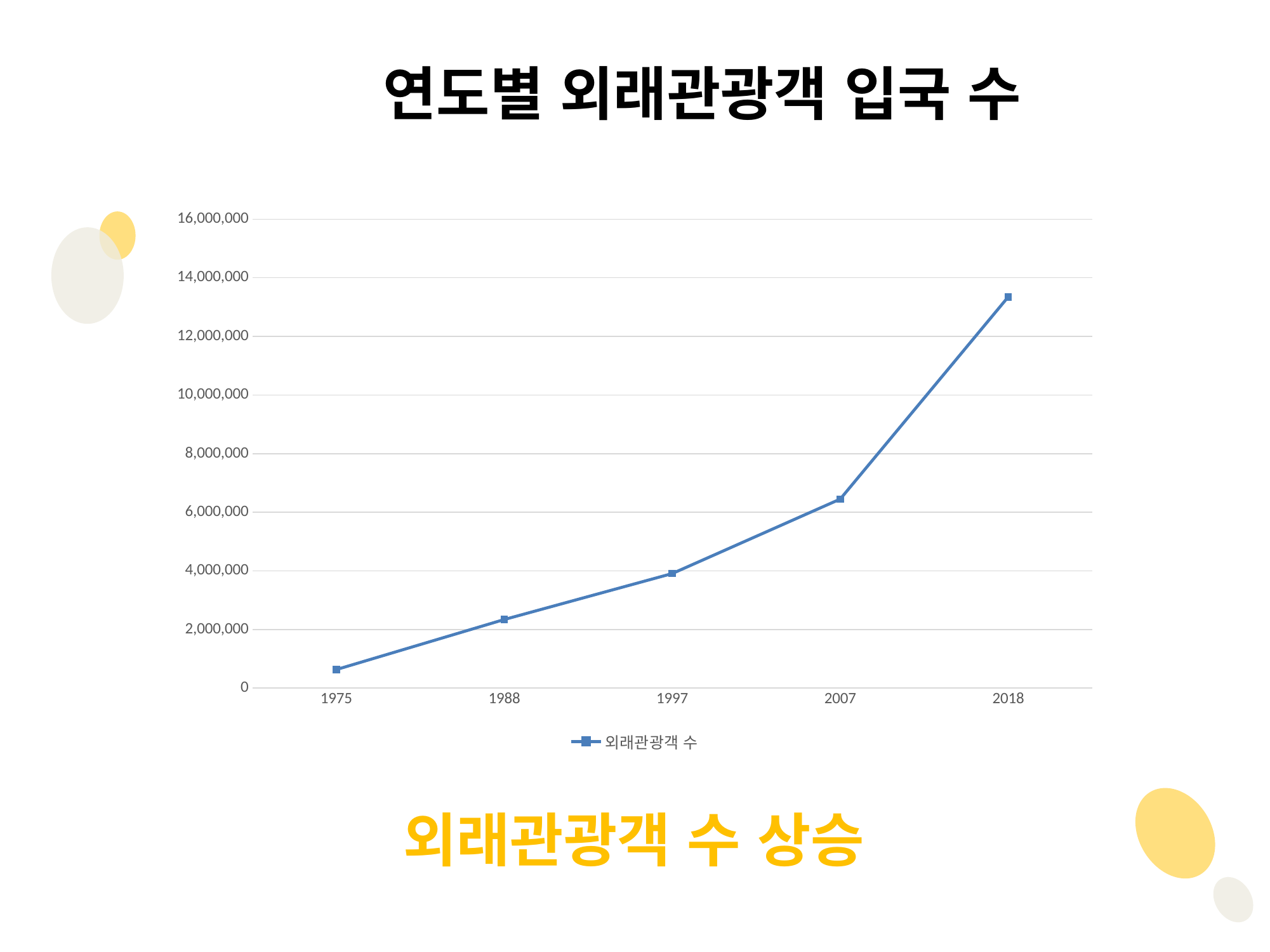
Is the value for 2007 greater or less than 8,000,000? less Which year has the lowest number of foreign tourist arrivals? 1975 How many series does the legend list? 1 Do the values rise or fall from 1975 to 2018? rise Which year has the highest number of foreign tourist arrivals? 2018 Is the value for 1975 greater or less than 2,000,000? less What is the title of the chart? 연도별 외래관광객 입국 수 How many years are plotted on the x axis of the chart? 5 Is the value for 2018 greater or less than 12,000,000? greater What kind of chart is shown on the slide? line chart What is the name of the series shown in the legend? 외래관광객 수 Which year has a larger value, 1997 or 2007? 2007